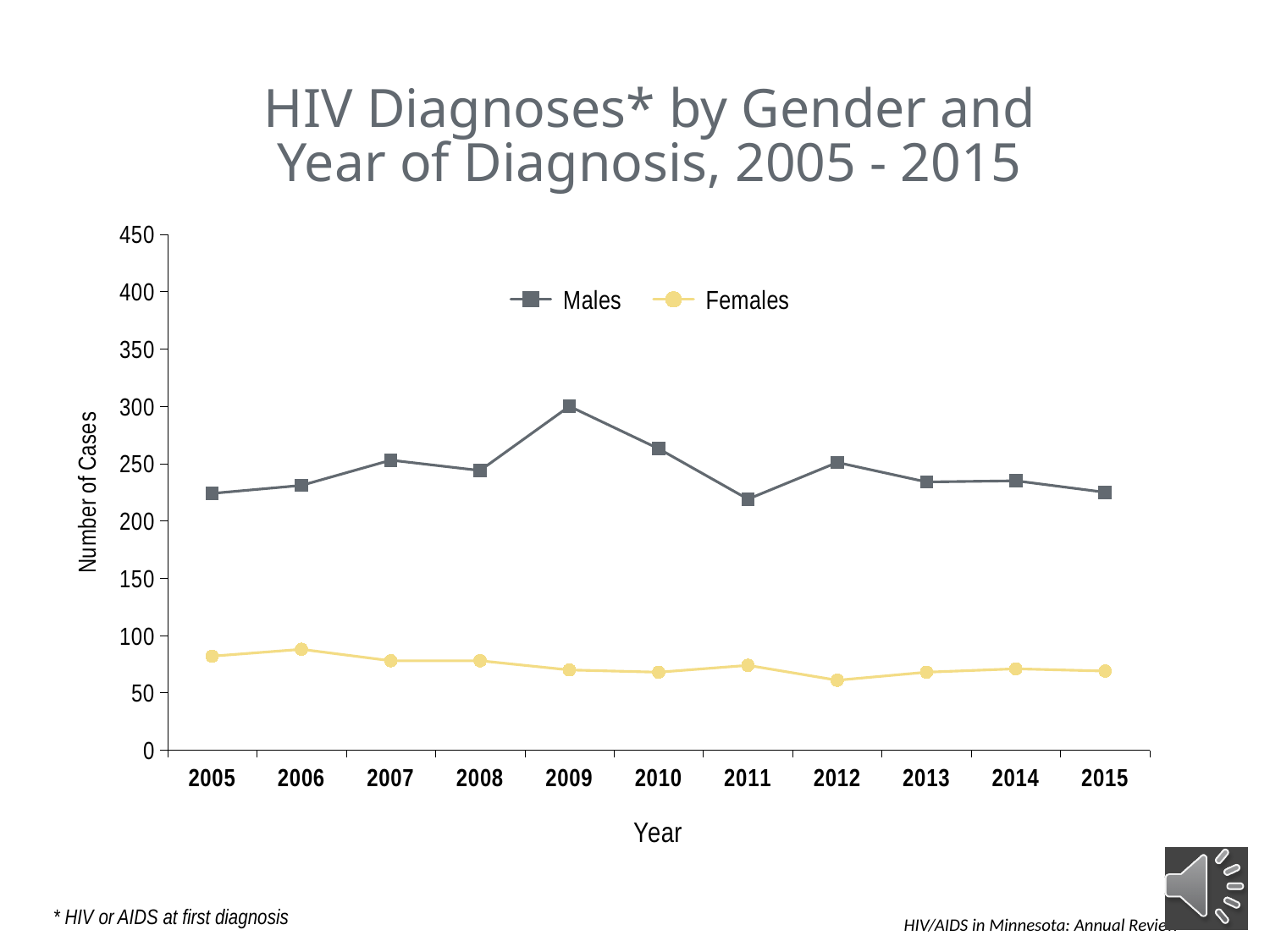
Which series has the larger value in 2010, Males or Females? Males In which year is the Males series at its highest? 2009 Is the value for Males in 2011 greater or less than 250? less How many years are plotted along the x axis? 11 What kind of chart is shown on the slide? line chart Do the Males values rise or fall from 2009 to 2011? fall In which year is the Females series at its lowest? 2012 Is the value for Females in 2005 greater or less than 100? less What is the title of the vertical axis? Number of Cases Is the value for Males in 2009 greater or less than 250? greater How many series does the legend list? 2 In which year is the Females series at its highest? 2006